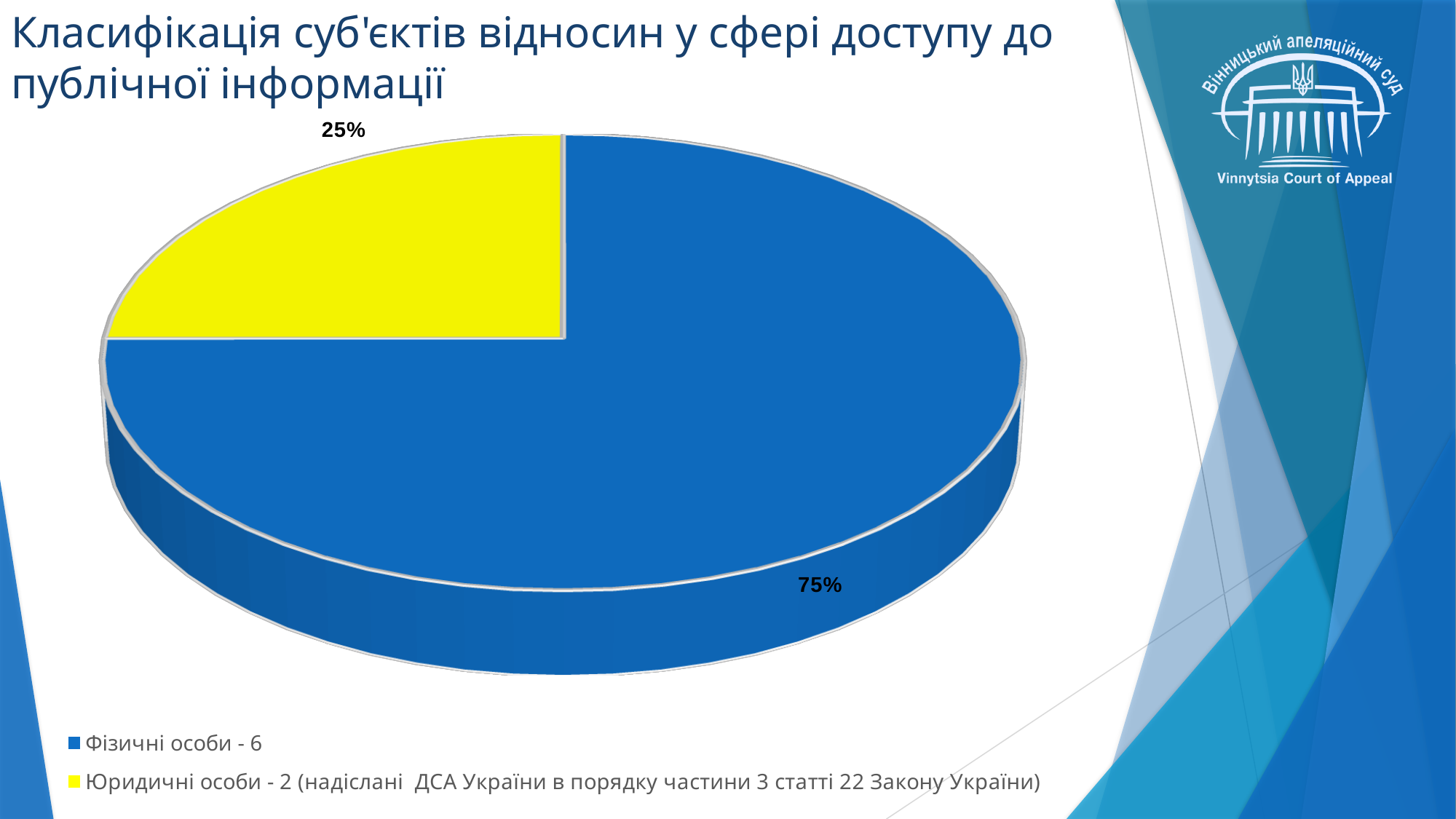
What is the difference in percentage points between the Фізичні особи slice and the Юридичні особи slice? 50 Which slice is larger: Фізичні особи or Юридичні особи? Фізичні особи What share of the pie does the slice for Юридичні особи take? 25% What share of the pie does the slice for Фізичні особи take? 75% Which category has the largest slice of the pie? Фізичні особи Which category has the smallest slice of the pie? Юридичні особи According to the legend, how many Юридичні особи are there? 2 What colour is the slice for Юридичні особи? yellow According to the legend, how many Фізичні особи are there? 6 How many slices does the pie chart have? 2 What kind of chart is shown on the slide? pie chart What is the title of the slide containing the pie chart? Класифікація суб'єктів відносин у сфері доступу до публічної інформації